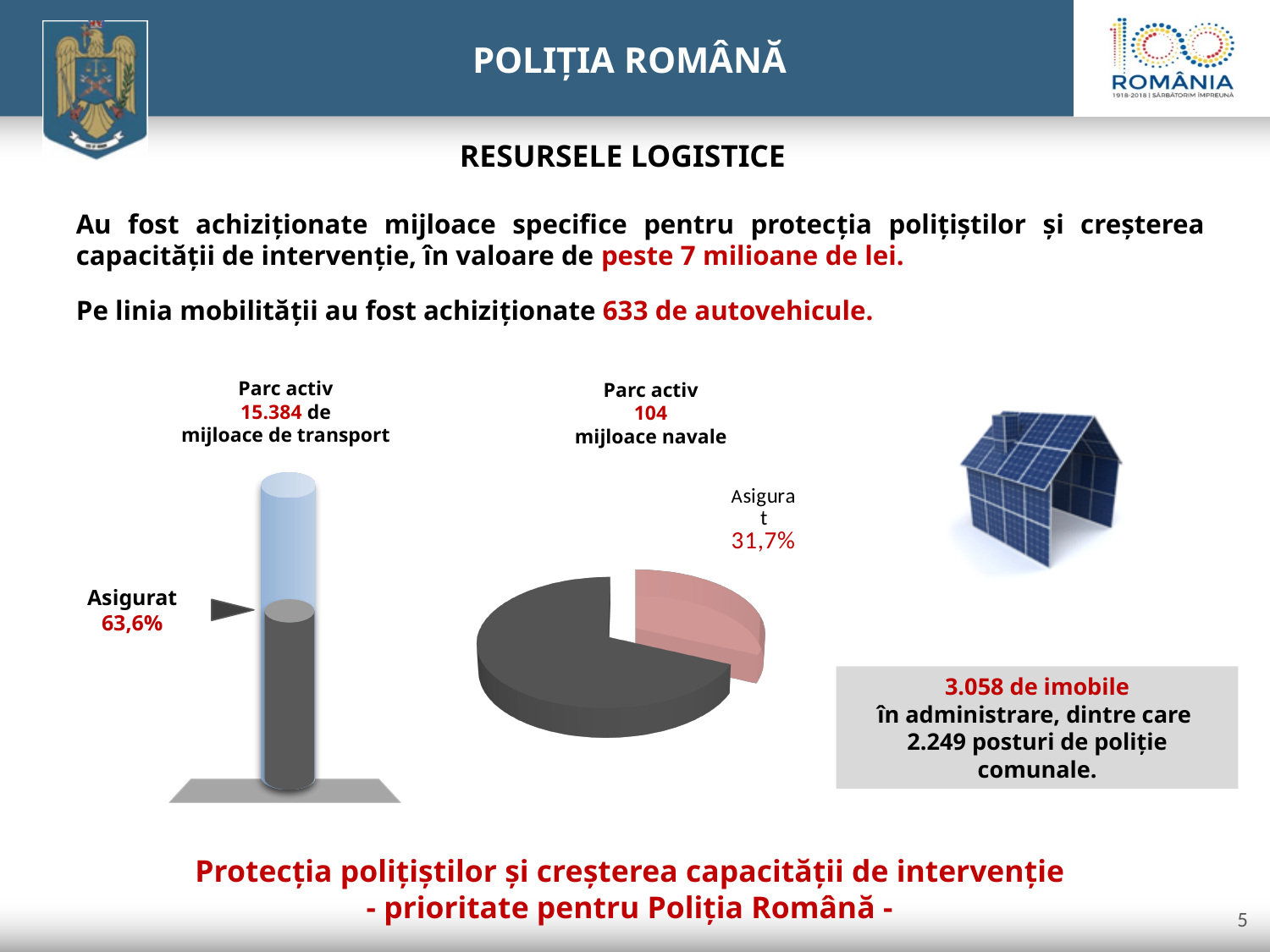
In the pie chart for mijloace navale, what share is labelled "Asigurat"? 31,7% In the pie chart for mijloace navale, is the "Asigurat" slice larger or smaller than the other slice? smaller What colour is the "Asigurat" slice in the pie chart for mijloace navale? pink What is the difference between the "Asigurat" percentage for mijloace de transport (63,6%) and for mijloace navale (31,7%)? 31,9 percentage points Which "Asigurat" percentage is larger: the one for mijloace de transport (left chart) or the one for mijloace navale (pie chart)? mijloace de transport How many slices does the pie chart for mijloace navale have? 2 In the cylinder bar chart for mijloace de transport, what percentage is labelled "Asigurat"? 63,6% What kind of chart is the chart in the middle of the slide, under "Parc activ 104 mijloace navale"? pie chart What is the "Parc activ" figure shown above the pie chart for mijloace navale? 104